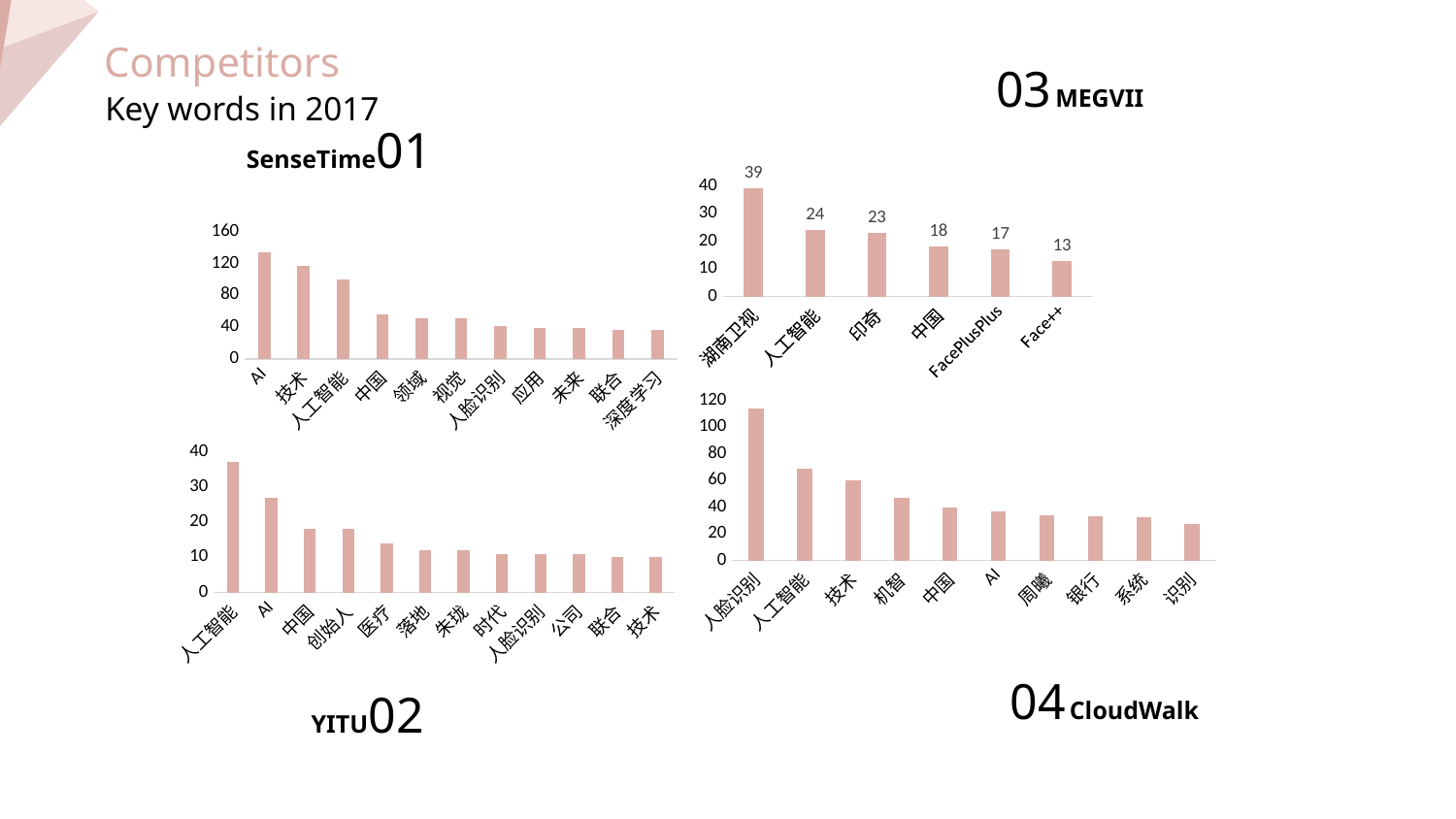
In the YITU chart, how many categories are plotted? 12 In the MEGVII chart, how many categories are plotted? 6 In the MEGVII chart, which category has the lowest value? Face++ In the CloudWalk chart, is the value for 人脸识别 greater or less than 100? greater In the MEGVII chart, what is the value for 湖南卫视? 39 In the MEGVII chart, what is the difference between the values for 湖南卫视 and 人工智能? 15 In the SenseTime chart, how many categories are plotted? 11 In the YITU chart, which is larger, the value for AI or the value for 中国? AI In the CloudWalk chart, do the values rise or fall from left to right along the x axis? fall In the SenseTime chart, which category has the highest value? AI In the MEGVII chart, what is the value for Face++? 13 In the SenseTime chart, is the value for AI greater or less than 120? greater